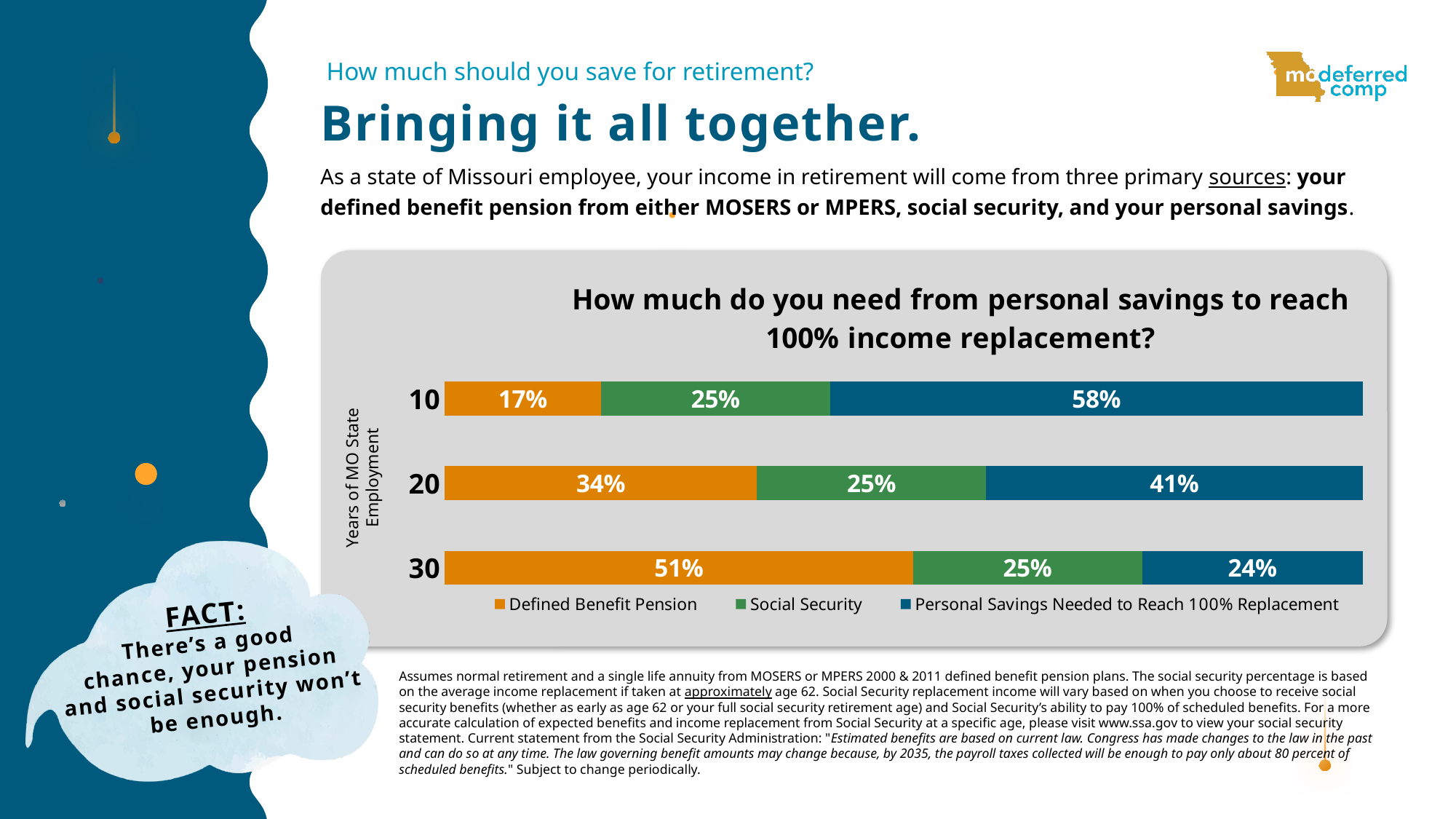
What is the Personal Savings Needed to Reach 100% Replacement value for 20 years of MO State Employment? 41% Does the Defined Benefit Pension value rise or fall as years of MO State Employment increase? Rise Which years-of-employment category has the lowest Personal Savings Needed to Reach 100% Replacement value? 30 What is the title of the chart? How much do you need from personal savings to reach 100% income replacement? What is the Defined Benefit Pension value for 10 years of MO State Employment? 17% Which years-of-employment category has the highest Defined Benefit Pension value? 30 How many series does the legend list? 3 What is the Social Security value for 30 years of MO State Employment? 25% Which is larger for 20 years of employment: the Defined Benefit Pension value or the Personal Savings Needed value? Personal Savings Needed to Reach 100% Replacement How many years-of-employment categories are shown in the chart? 3 What kind of chart is shown on the slide? Stacked bar chart What is the difference between the Personal Savings Needed values for 10 years and 30 years of employment? 34%